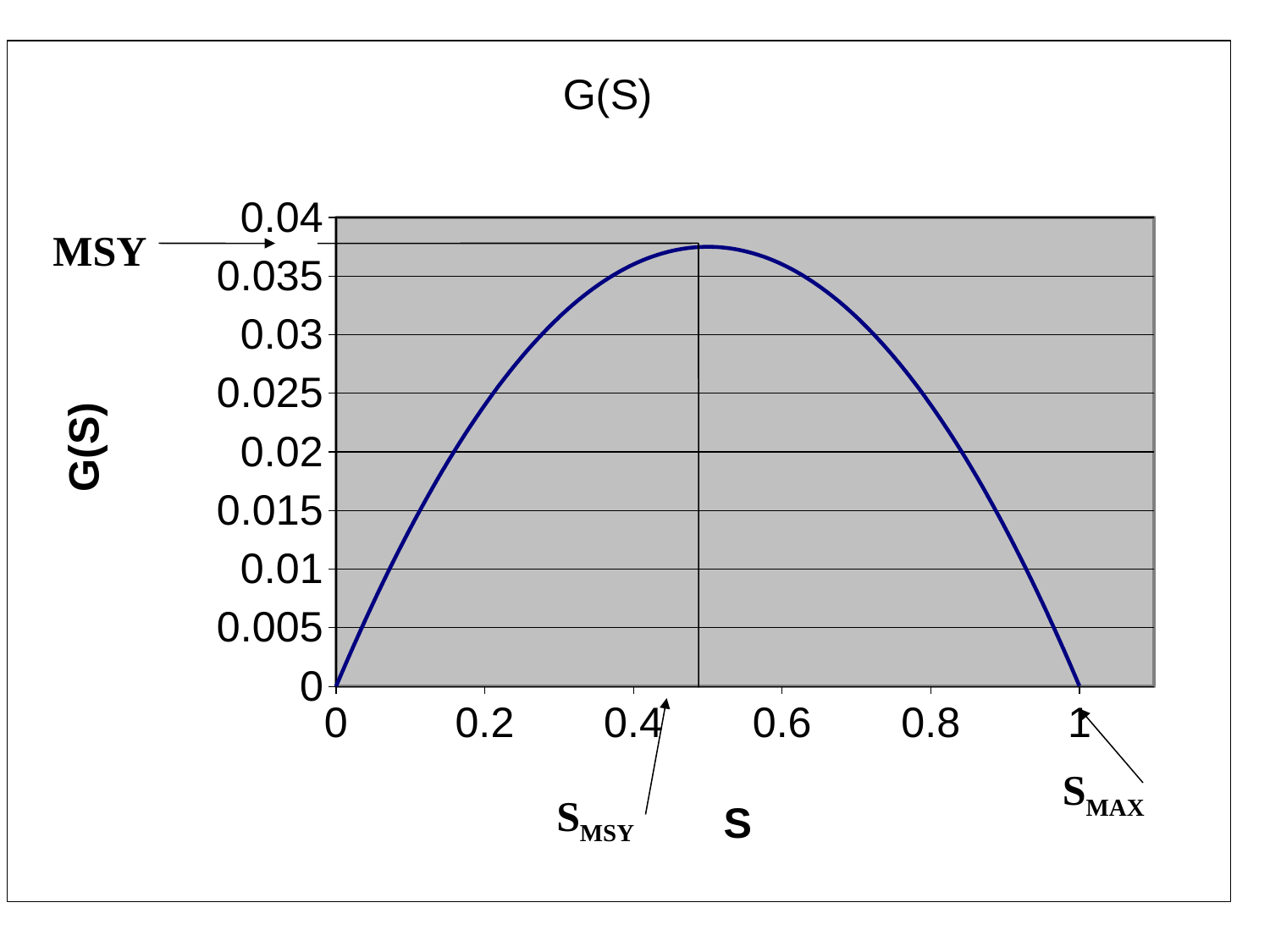
What is the label on the vertical axis of the chart? G(S) What kind of chart is shown on the slide? line chart Is the value of G(S) at S = 0.2 greater or less than 0.02? greater How does G(S) change as S increases from 0 to 1? rises then falls Which of the two values is larger: G(S) at S = 0.4 or G(S) at S = 0.9? S = 0.4 Is the value of G(S) at S = 0.6 greater or less than 0.03? greater Is the value of G(S) at S = 0.8 greater or less than 0.03? less What is the title of the chart? G(S) What is the value of G(S) at S = 0? 0 What is the value of G(S) at S = 1? 0